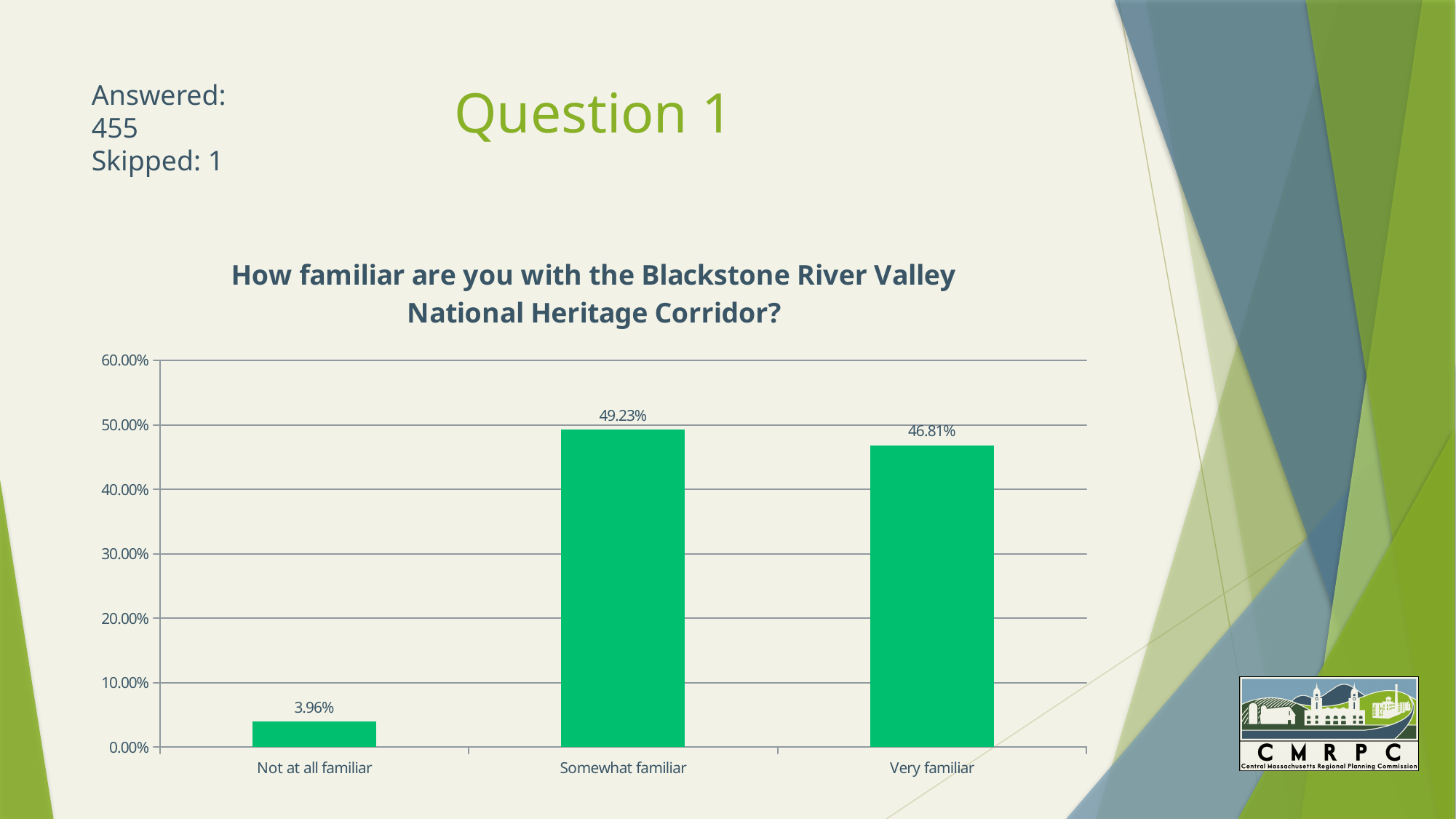
What is the difference in percentage points between 'Somewhat familiar' and 'Very familiar'? 2.42% What is the title of the chart? How familiar are you with the Blackstone River Valley National Heritage Corridor? What is the difference in percentage points between 'Very familiar' and 'Not at all familiar'? 42.85% Is the value for 'Somewhat familiar' greater or less than 40.00%? greater What percentage of respondents said they are 'Somewhat familiar'? 49.23% How many response categories are shown on the x axis? 3 What type of chart is shown on the slide? Bar chart Which response category has the lowest percentage? Not at all familiar What percentage of respondents said they are 'Very familiar'? 46.81% Which is larger: the value for 'Very familiar' or the value for 'Not at all familiar'? Very familiar What percentage of respondents said they are 'Not at all familiar' with the Blackstone River Valley National Heritage Corridor? 3.96% Which response category has the highest percentage? Somewhat familiar